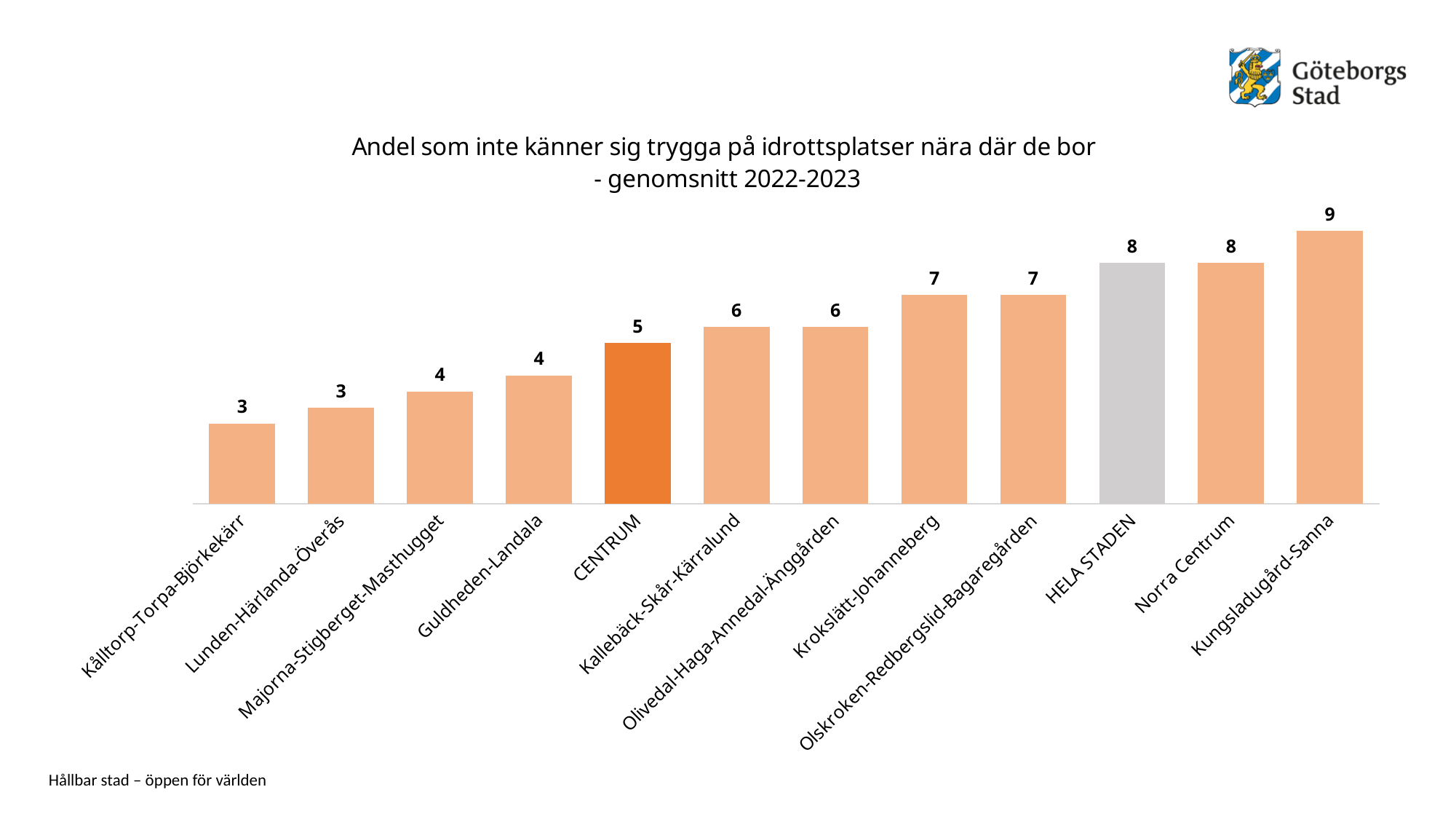
What is the value for Guldheden-Landala? 4 What is the value for CENTRUM? 5 What is the value for HELA STADEN? 8 Do the values rise or fall from left to right along the x axis? Rise What is the value for Kungsladugård-Sanna? 9 Which category has the highest value? Kungsladugård-Sanna How many categories are shown in the chart? 12 What is the difference between the values for Norra Centrum and Lunden-Härlanda-Överås? 5 Which bar is shown in grey rather than orange? HELA STADEN What is the difference between the values for Kungsladugård-Sanna and CENTRUM? 4 Which is larger, the value for Krokslätt-Johanneberg or the value for Guldheden-Landala? Krokslätt-Johanneberg What kind of chart is shown on the slide? Bar chart